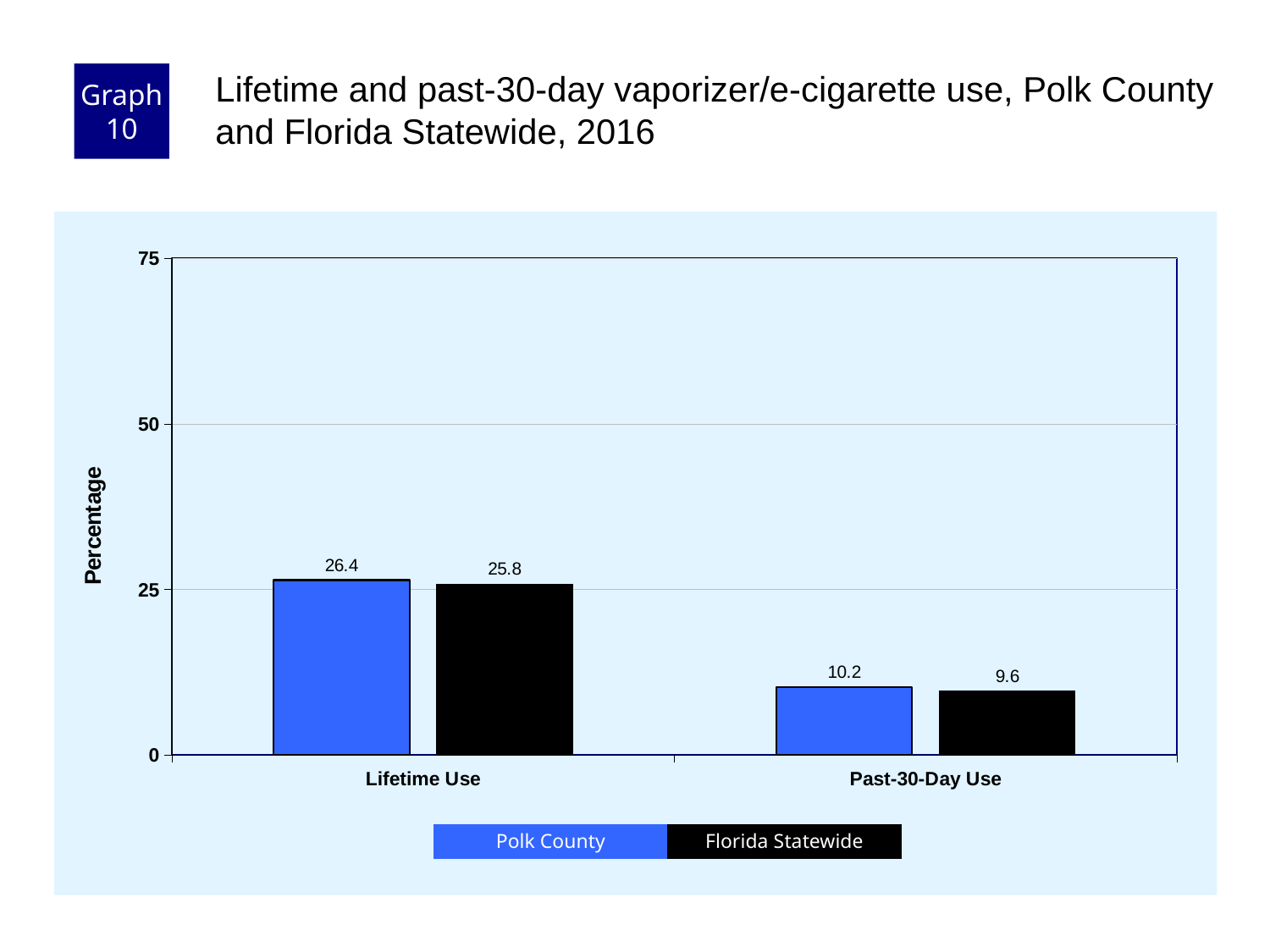
What is the label of the vertical axis? Percentage Which category has the highest Polk County value? Lifetime Use What is the difference between the Polk County values for Lifetime Use and Past-30-Day Use? 16.2 Which category has the lowest Florida Statewide value? Past-30-Day Use What is the difference between the Polk County and Florida Statewide values for Lifetime Use? 0.6 What is the Florida Statewide value for Lifetime Use? 25.8 What is the Polk County value for Lifetime Use? 26.4 How many series does the legend list? 2 What is the Florida Statewide value for Past-30-Day Use? 9.6 What kind of chart is shown on the slide? Bar chart Which is larger for Past-30-Day Use: Polk County or Florida Statewide? Polk County What is the Polk County value for Past-30-Day Use? 10.2